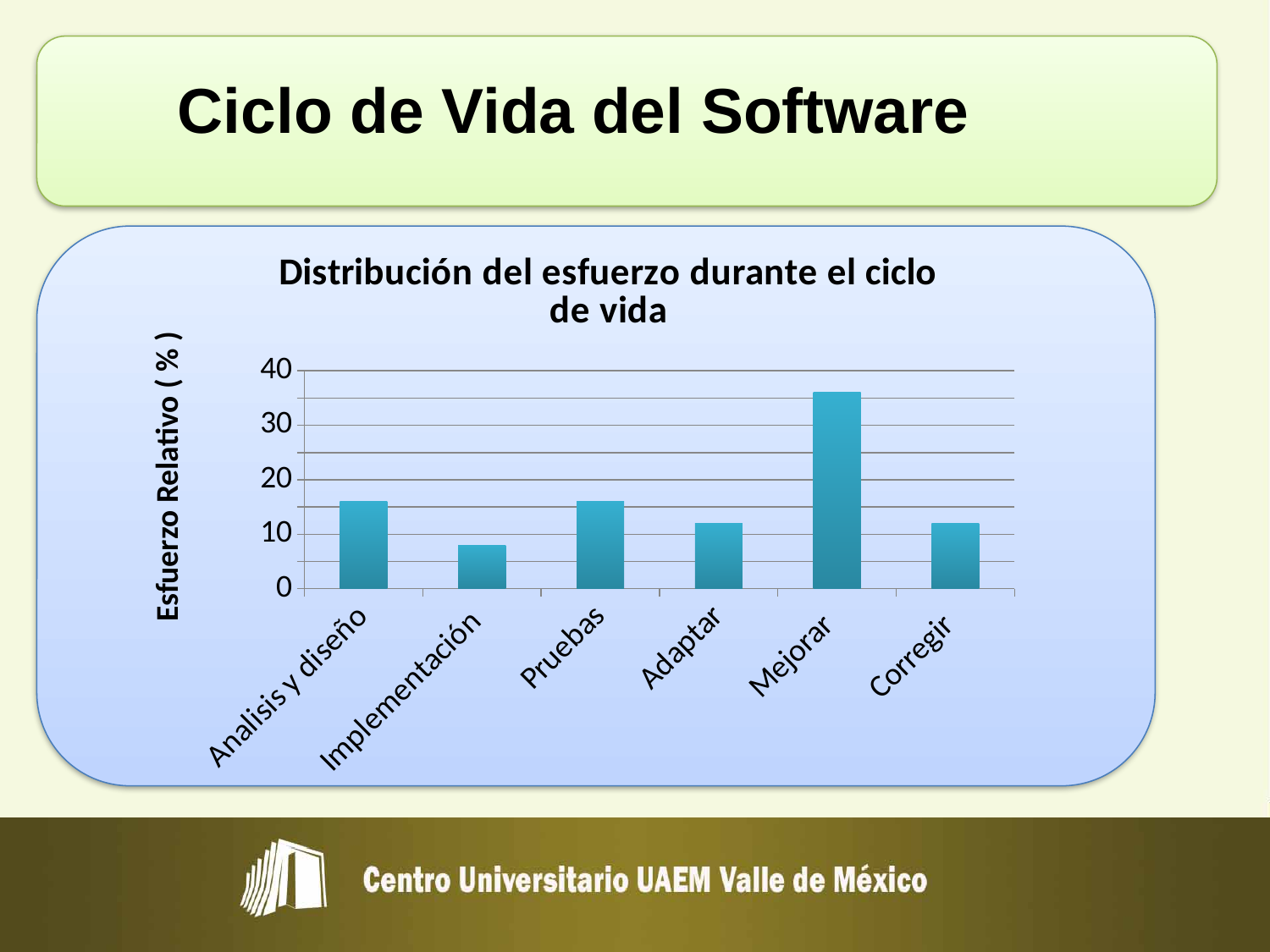
Is the value for Adaptar greater or less than 10? greater Is the value for Mejorar greater or less than 30? greater Which category has the lowest value? Implementación What kind of chart is shown on the slide? bar chart What is the label of the vertical axis? Esfuerzo Relativo ( % ) Is the value for Pruebas greater or less than 20? less Which is larger, the value for Analisis y diseño or the value for Implementación? Analisis y diseño What is the title of the chart? Distribución del esfuerzo durante el ciclo de vida Which category has the highest value? Mejorar Which is larger, the value for Mejorar or the value for Pruebas? Mejorar How many categories are shown on the x axis of the chart? 6